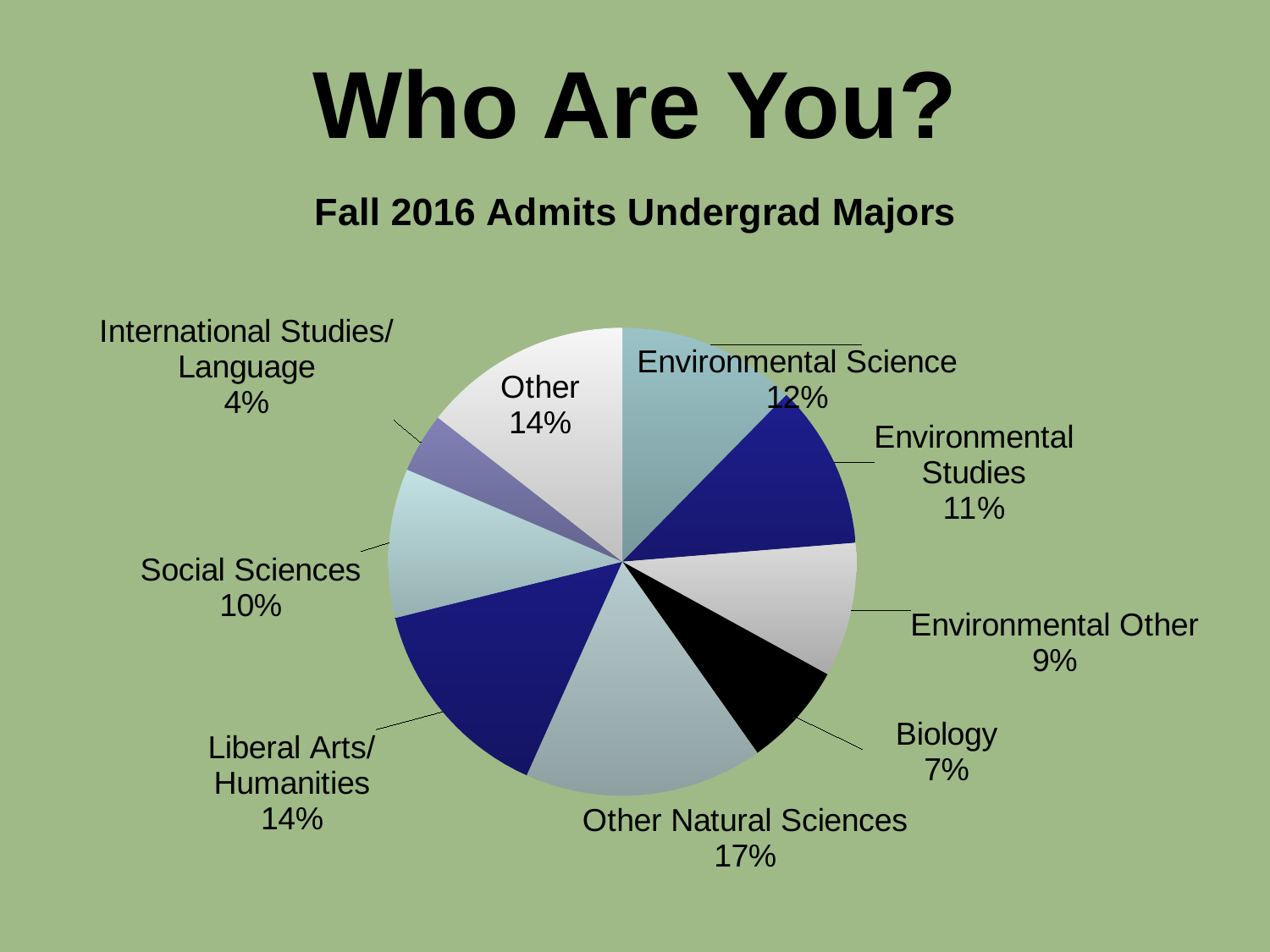
Which category has the smallest slice of the pie? International Studies/Language What kind of chart is shown on the slide? pie chart What share of the pie is Other Natural Sciences? 17% What percentage is shown for Environmental Science? 12% What percentage is shown for Biology? 7% What is the chart's title? Fall 2016 Admits Undergrad Majors How many slices does the pie chart have? 9 Which is larger, Environmental Studies or Environmental Other? Environmental Studies Which category has the largest slice of the pie? Other Natural Sciences What is the difference in percentage points between Other Natural Sciences and Biology? 10 What is the difference in percentage points between Environmental Science and Social Sciences? 2 What percentage is shown for Social Sciences? 10%